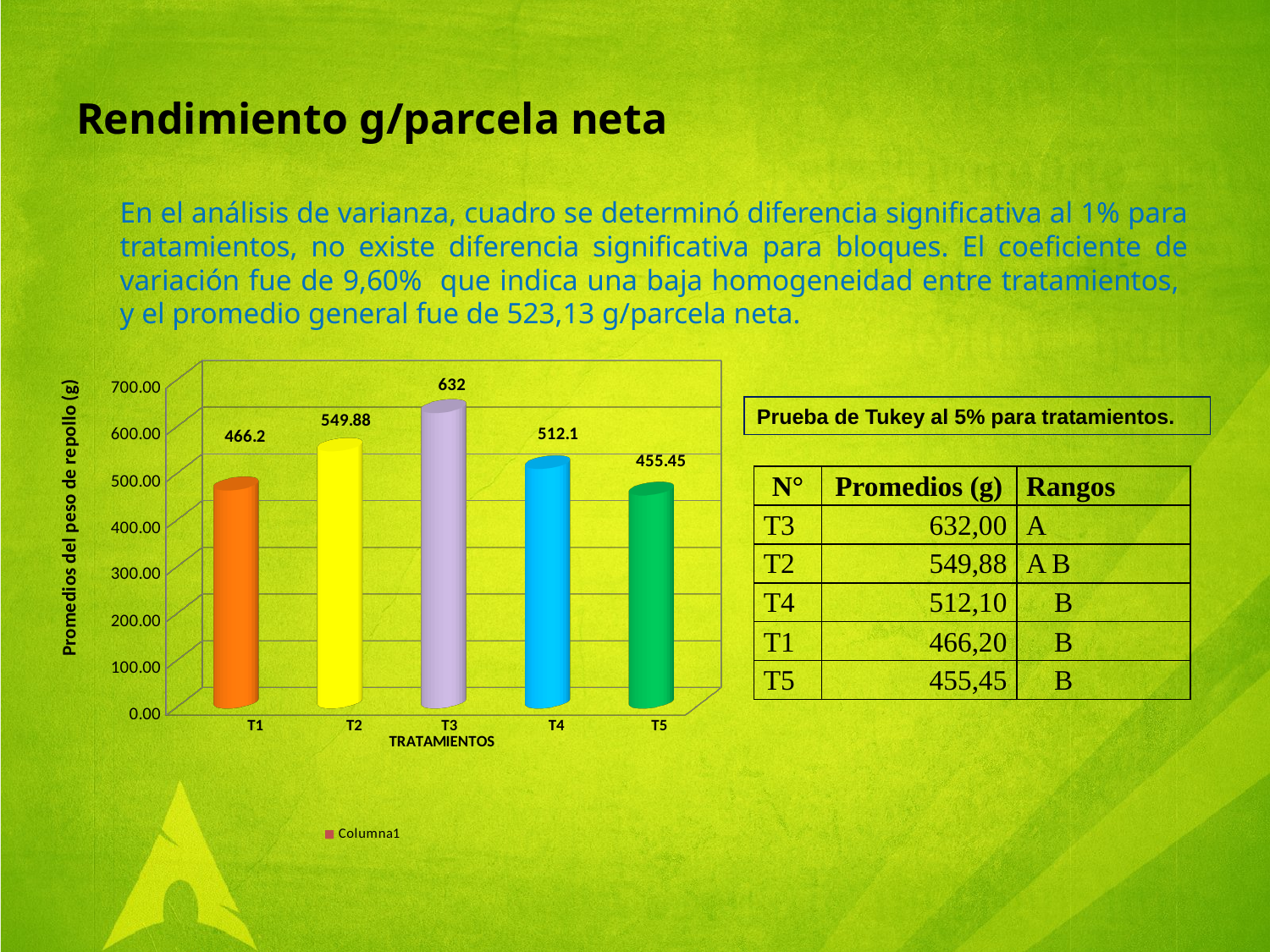
What is the value for T3 in the chart? 632 Which treatment has the highest value in the chart? T3 What is the value for T5 in the chart? 455.45 What is the difference between the values for T4 and T1? 45.9 Which treatment has the lowest value in the chart? T5 Which is larger, the value for T2 or the value for T4? T2 Is the value for T3 greater or less than 600.00? greater What is the difference between the values for T3 and T2? 82.12 How many treatments are shown on the x axis of the chart? 5 What is the label of the y axis of the chart? Promedios del peso de repollo (g) What kind of chart is shown on the slide? bar chart What is the value for T1 in the chart? 466.2